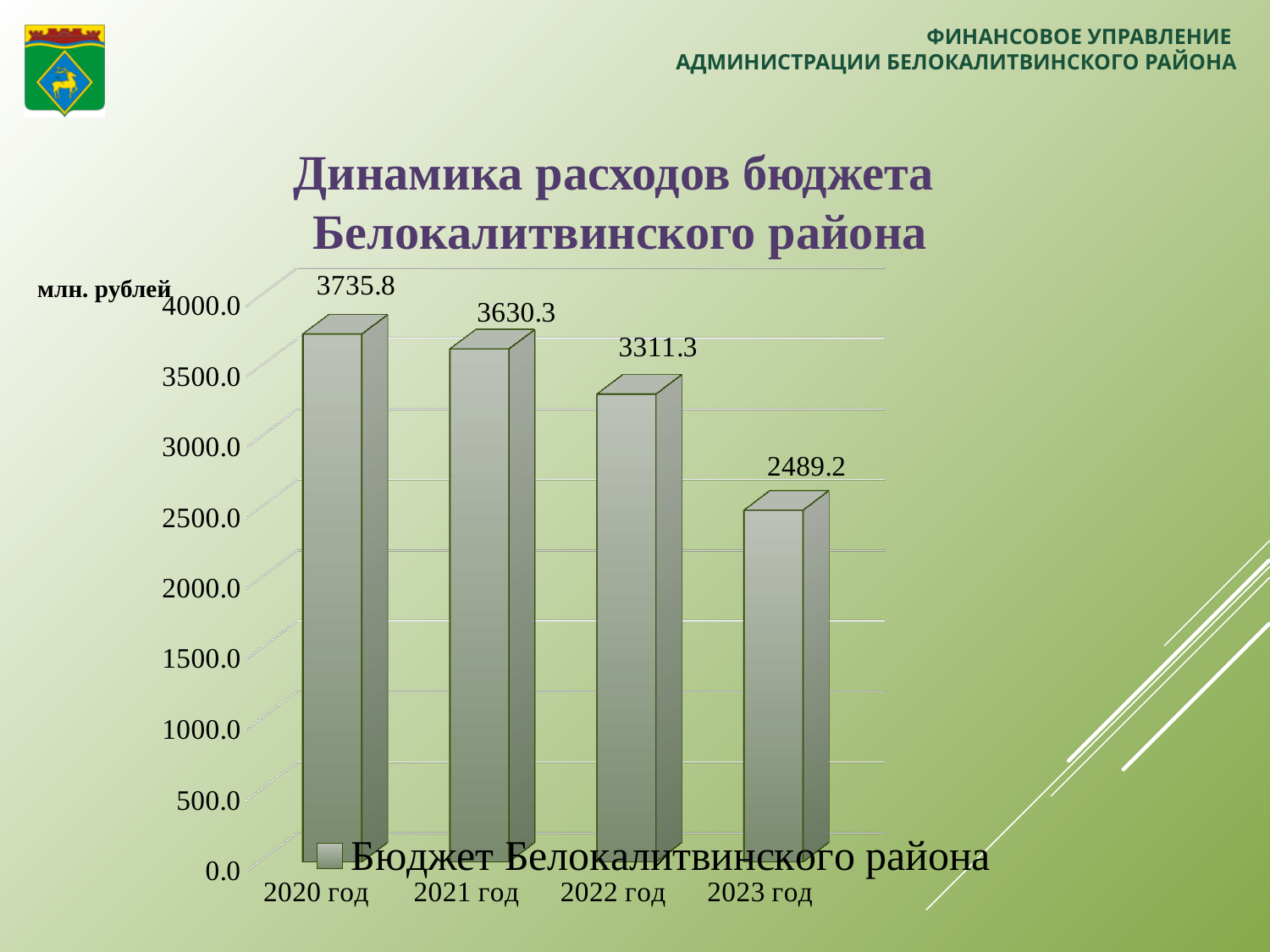
What is the value for 2023 год? 2489.2 How many years are shown on the x axis? 4 What is the difference between the values for 2020 год and 2023 год? 1246.6 What is the value for 2020 год? 3735.8 Which year has the highest value? 2020 год What is the difference between the values for 2021 год and 2022 год? 319.0 Is the value for 2023 год greater or less than 3000.0? less What kind of chart is shown on the slide? bar chart Do the values rise or fall from 2020 год to 2023 год? fall Which is larger, the value for 2021 год or the value for 2022 год? 2021 год What is the value for 2022 год? 3311.3 Which year has the lowest value? 2023 год